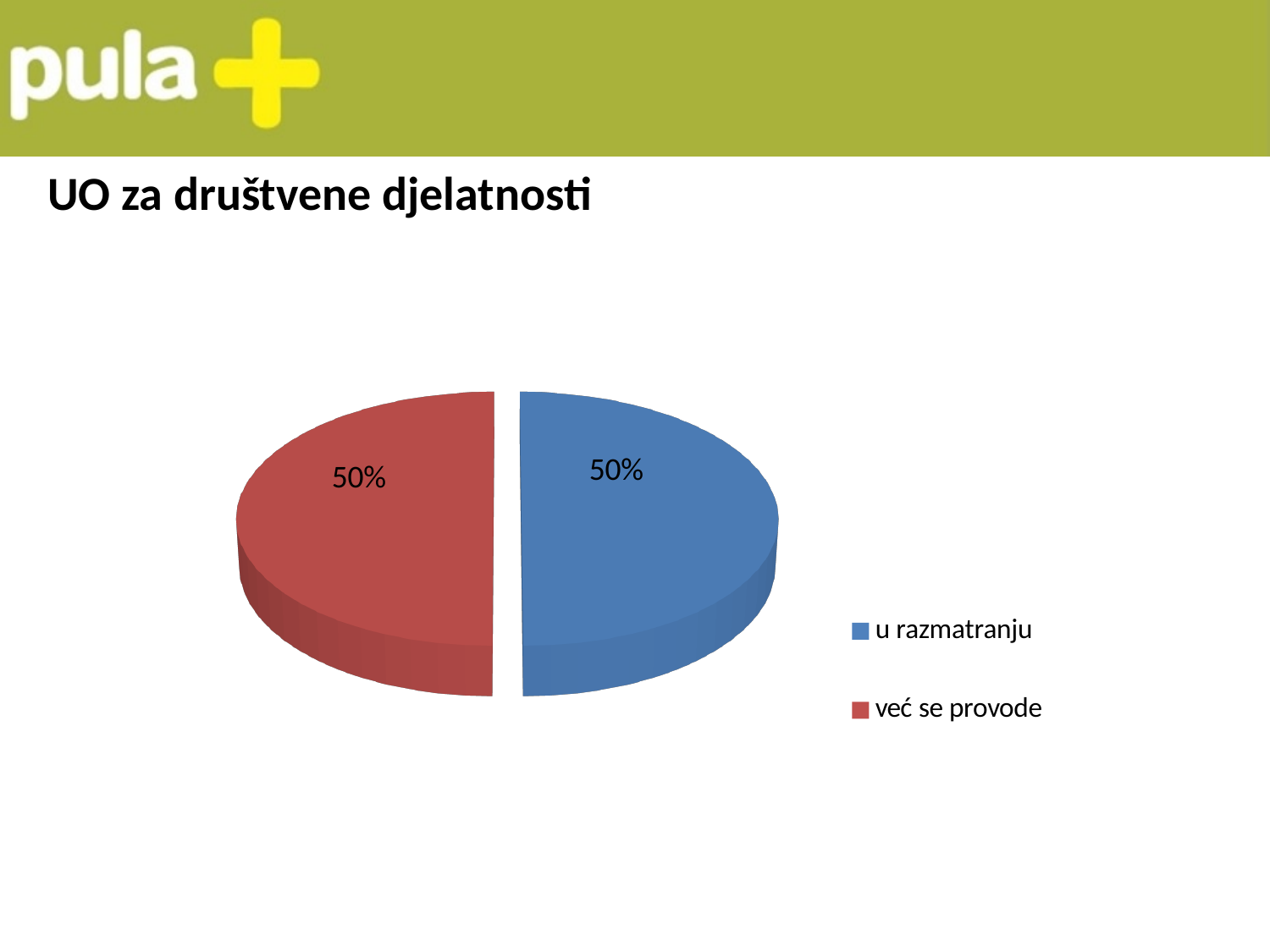
What share of the pie does "u razmatranju" take? 50% Which colour represents "u razmatranju" in the pie chart? blue How many entries does the legend list? 2 What share of the pie does "već se provode" take? 50% Which colour represents "već se provode" in the pie chart? red What is the combined share of "u razmatranju" and "već se provode"? 100% How many slices does the pie chart have? 2 Is the share for "već se provode" greater or less than 25%? greater What is the difference between the shares of "u razmatranju" and "već se provode"? 0% What kind of chart is shown on the slide? pie chart